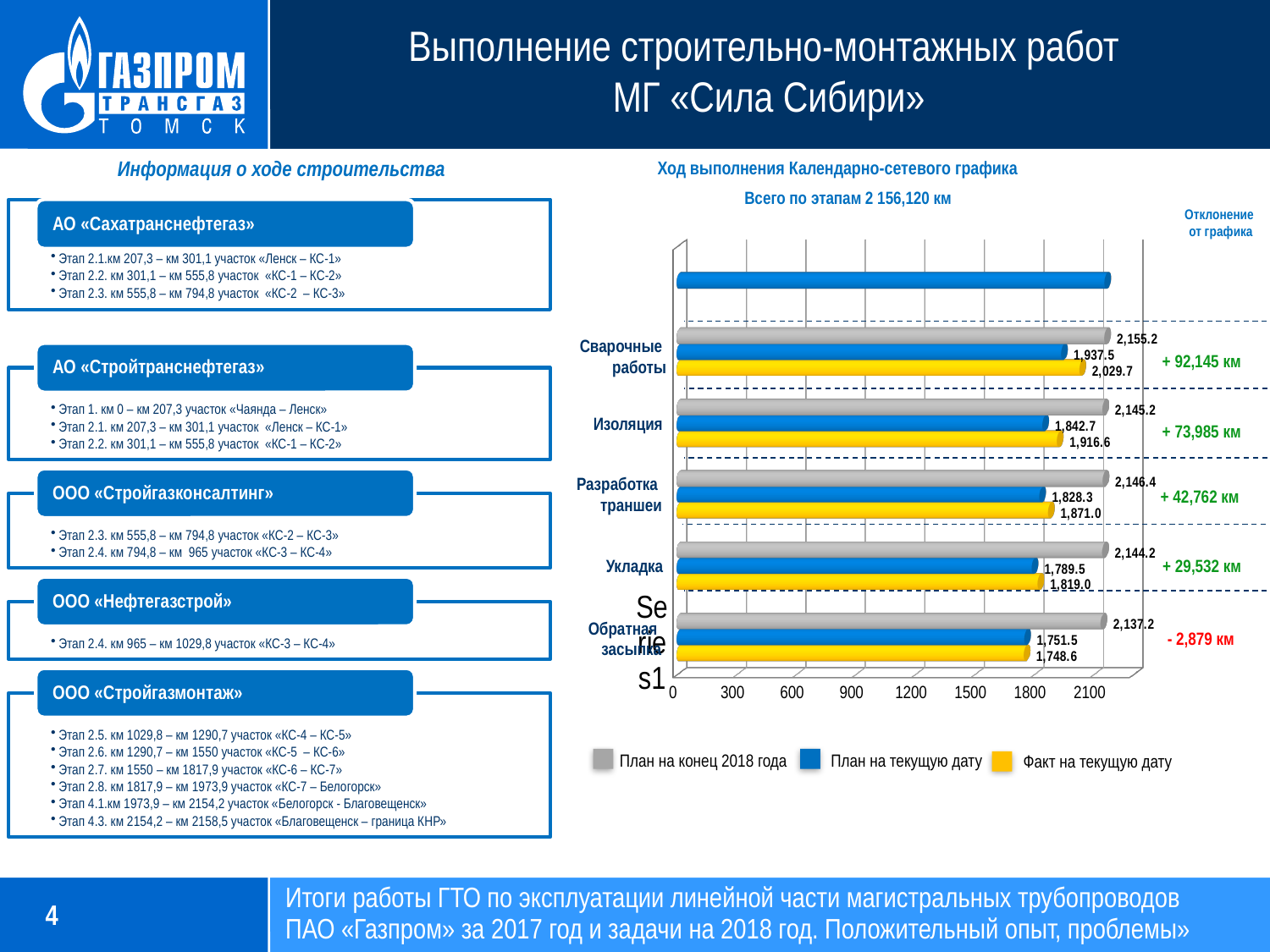
What is the value of «План на текущую дату» for «Укладка»? 1,789.5 For «Разработка траншеи», which is larger: «План на текущую дату» or «Факт на текущую дату»? Факт на текущую дату What is the difference between «Факт на текущую дату» and «План на текущую дату» for «Сварочные работы»? 92.2 How many series does the legend list? 3 Which category has the lowest value for «Факт на текущую дату»? Обратная засыпка What is the value of «Факт на текущую дату» for «Изоляция»? 1,916.6 What kind of chart is shown on the slide? bar chart What is the value of «План на конец 2018 года» for «Сварочные работы»? 2,155.2 What is the value of «Факт на текущую дату» for «Обратная засыпка»? 1,748.6 Which colour represents «Факт на текущую дату» in the legend? yellow Which category has the highest value for «План на конец 2018 года»? Сварочные работы Is the value of «Факт на текущую дату» for «Обратная засыпка» greater or less than 1800? less